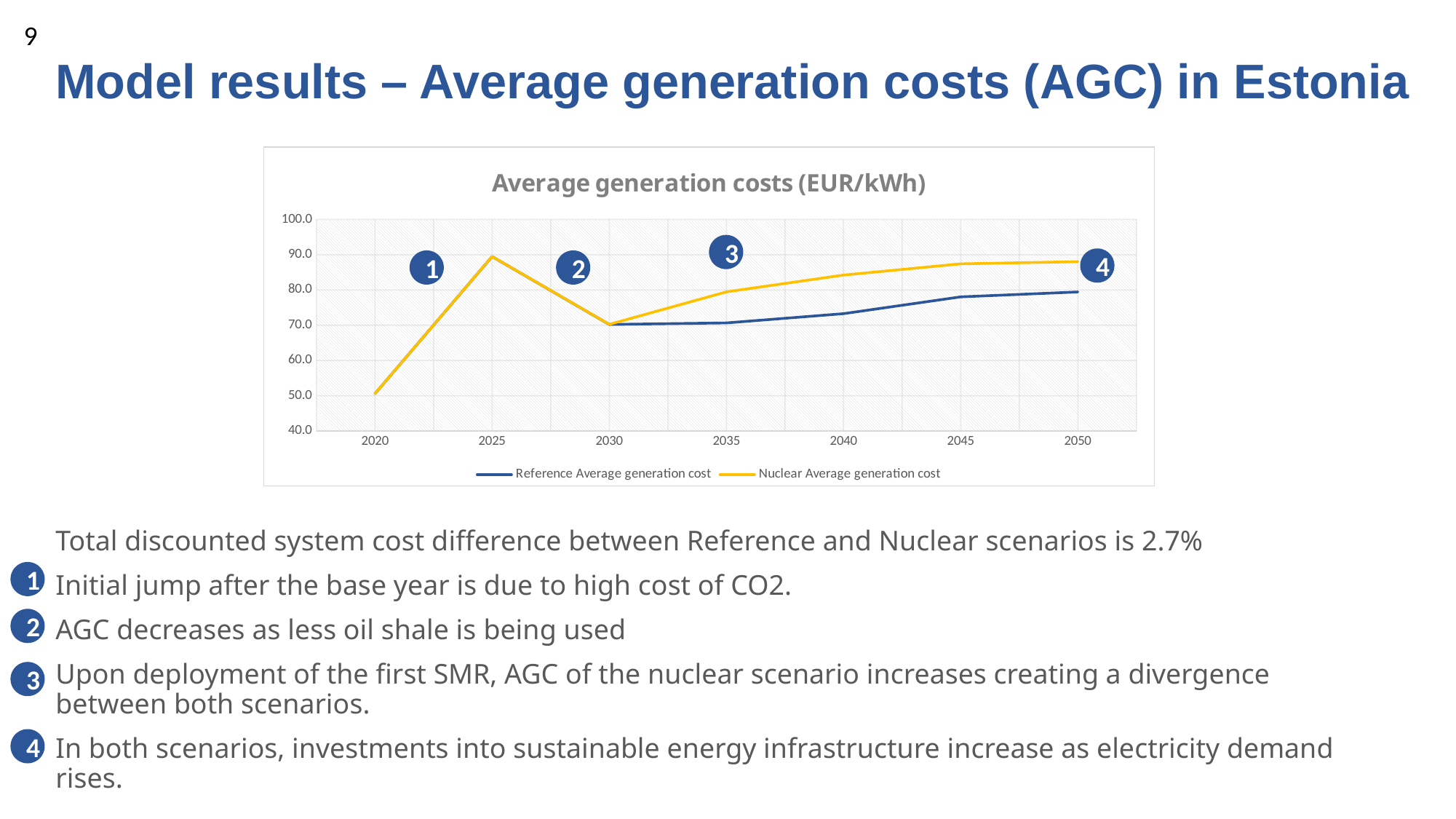
Is the average generation cost in 2020 greater or less than 60? less What is the title of the chart? Average generation costs (EUR/kWh) Does the Nuclear Average generation cost rise or fall from 2030 to 2050? rise Is the Nuclear Average generation cost in 2025 greater or less than 80? greater In which year is the Nuclear Average generation cost lowest? 2020 Which colour is used for the Nuclear Average generation cost line? yellow In 2040, which series has the higher value, Reference Average generation cost or Nuclear Average generation cost? Nuclear Average generation cost What kind of chart is shown on the slide? line chart How many years are marked on the x axis of the chart? 7 How many series does the chart legend list? 2 Is the Nuclear Average generation cost in 2035 greater or less than 70? greater